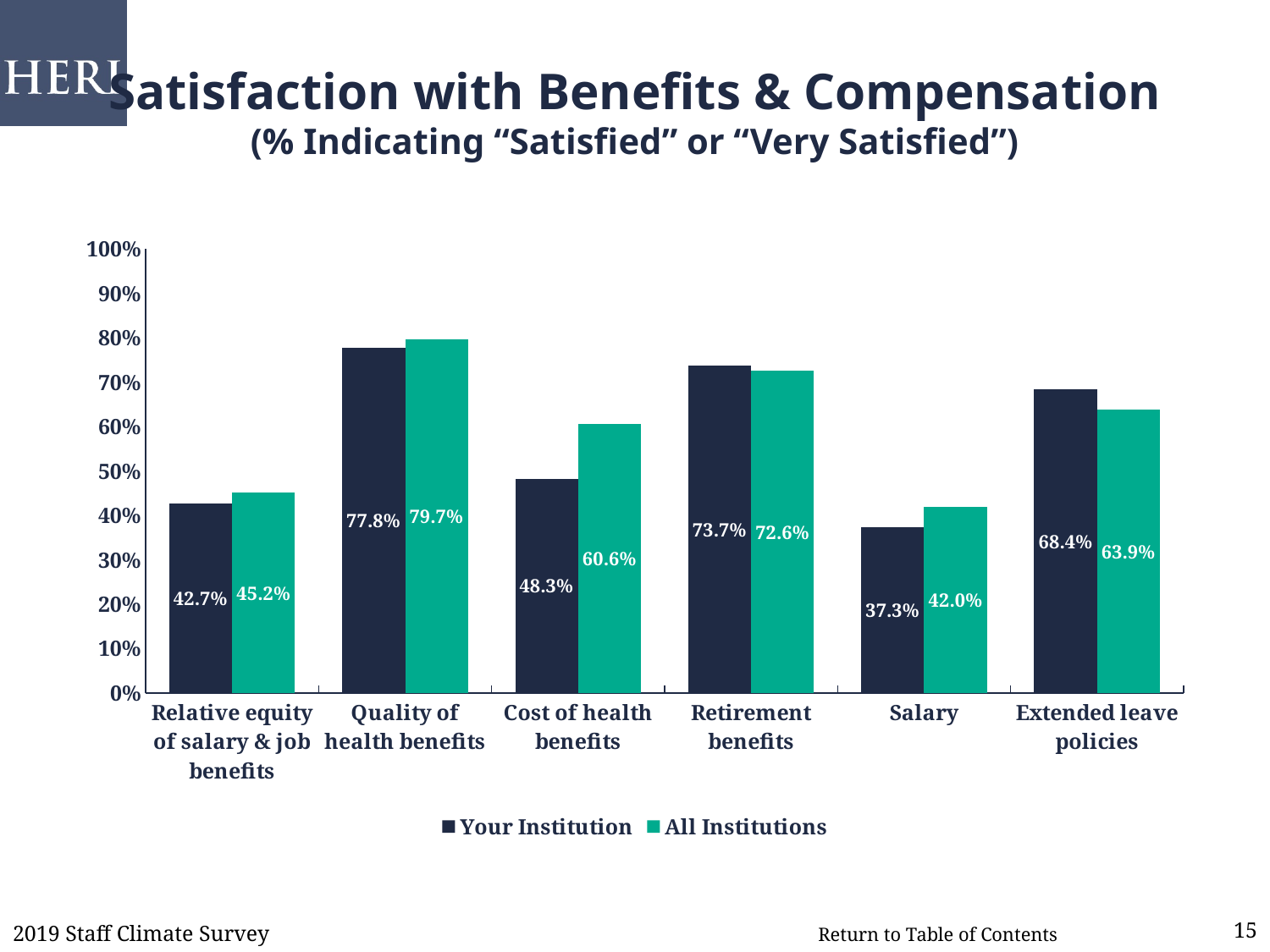
What is the title of the chart? Satisfaction with Benefits & Compensation What kind of chart is shown on the slide? Bar chart Which category has the lowest value for Your Institution? Salary What is the value for Your Institution for Salary? 37.3% How many categories are shown on the x axis? 6 What is the value for Your Institution for Quality of health benefits? 77.8% What is the value for All Institutions for Cost of health benefits? 60.6% How many series does the legend list? 2 Which is larger for Retirement benefits: Your Institution or All Institutions? Your Institution Is the value for Your Institution for Extended leave policies greater or less than 60%? greater Which category has the highest value for All Institutions? Quality of health benefits What is the difference between All Institutions and Your Institution for Cost of health benefits? 12.3%